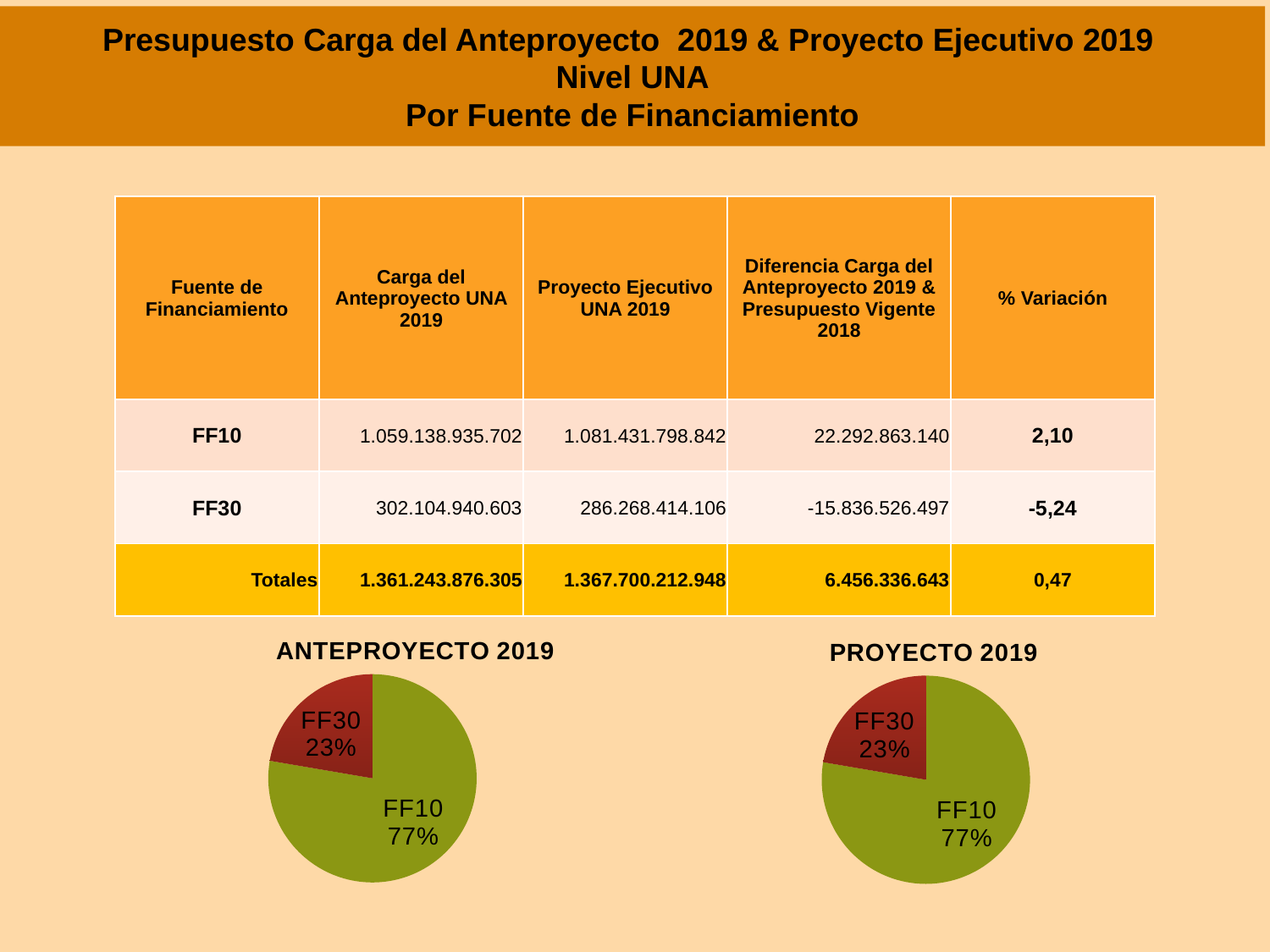
How many pie charts are shown on the slide? 2 In the ANTEPROYECTO 2019 chart, what share does FF10 have? 77% In the PROYECTO 2019 chart, what share does FF30 have? 23% In the PROYECTO 2019 chart, which slice is the smallest? FF30 In the ANTEPROYECTO 2019 chart, which slice is the largest? FF10 In the PROYECTO 2019 chart, what share does FF10 have? 77% What kind of chart is the PROYECTO 2019 chart? Pie chart In the ANTEPROYECTO 2019 chart, which is larger, FF10 or FF30? FF10 In the PROYECTO 2019 chart, what is the difference in percentage points between the FF10 and FF30 shares? 54 percentage points In the ANTEPROYECTO 2019 chart, how many slices does the pie have? 2 In the ANTEPROYECTO 2019 chart, what colour is the FF30 slice? Dark red